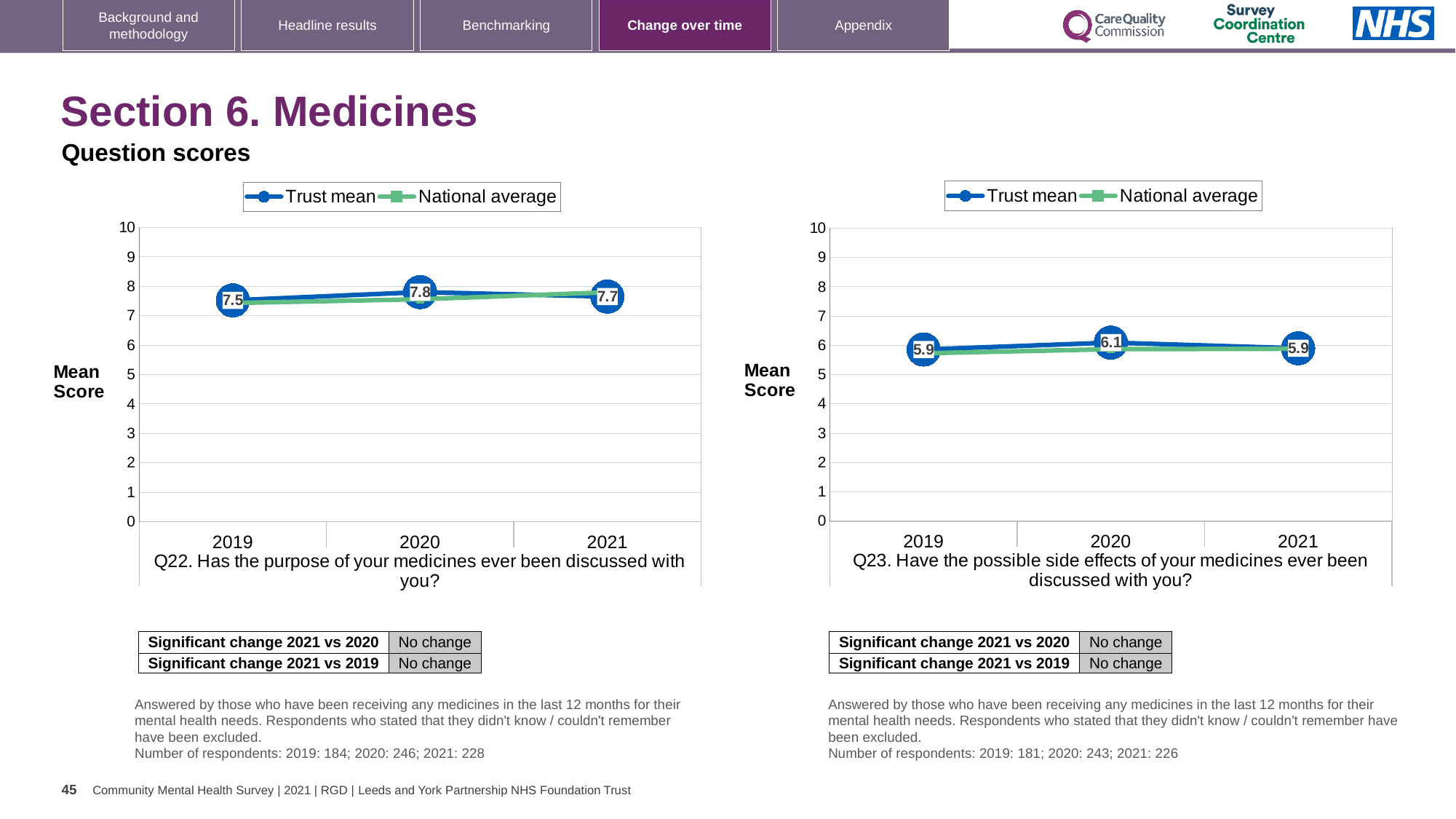
In the left chart (Q22), is the Trust mean for 2021 greater or less than 7? greater What kind of chart is the left chart (Q22)? Line chart In the left chart (Q22), which year has the highest Trust mean? 2020 How many series does the legend of the right chart (Q23) list? 2 In the right chart (Q23), what is the Trust mean for 2021? 5.9 In the left chart (Q22), what is the Trust mean for 2019? 7.5 In the right chart (Q23), what is the Trust mean for 2020? 6.1 In the left chart (Q22), what is the Trust mean for 2020? 7.8 In the left chart (Q22), which year has the lowest Trust mean? 2019 In the left chart (Q22), what is the difference between the Trust mean for 2020 and 2019? 0.3 In the right chart (Q23), which year has the highest Trust mean? 2020 In the right chart (Q23), what is the difference between the Trust mean for 2020 and 2021? 0.2